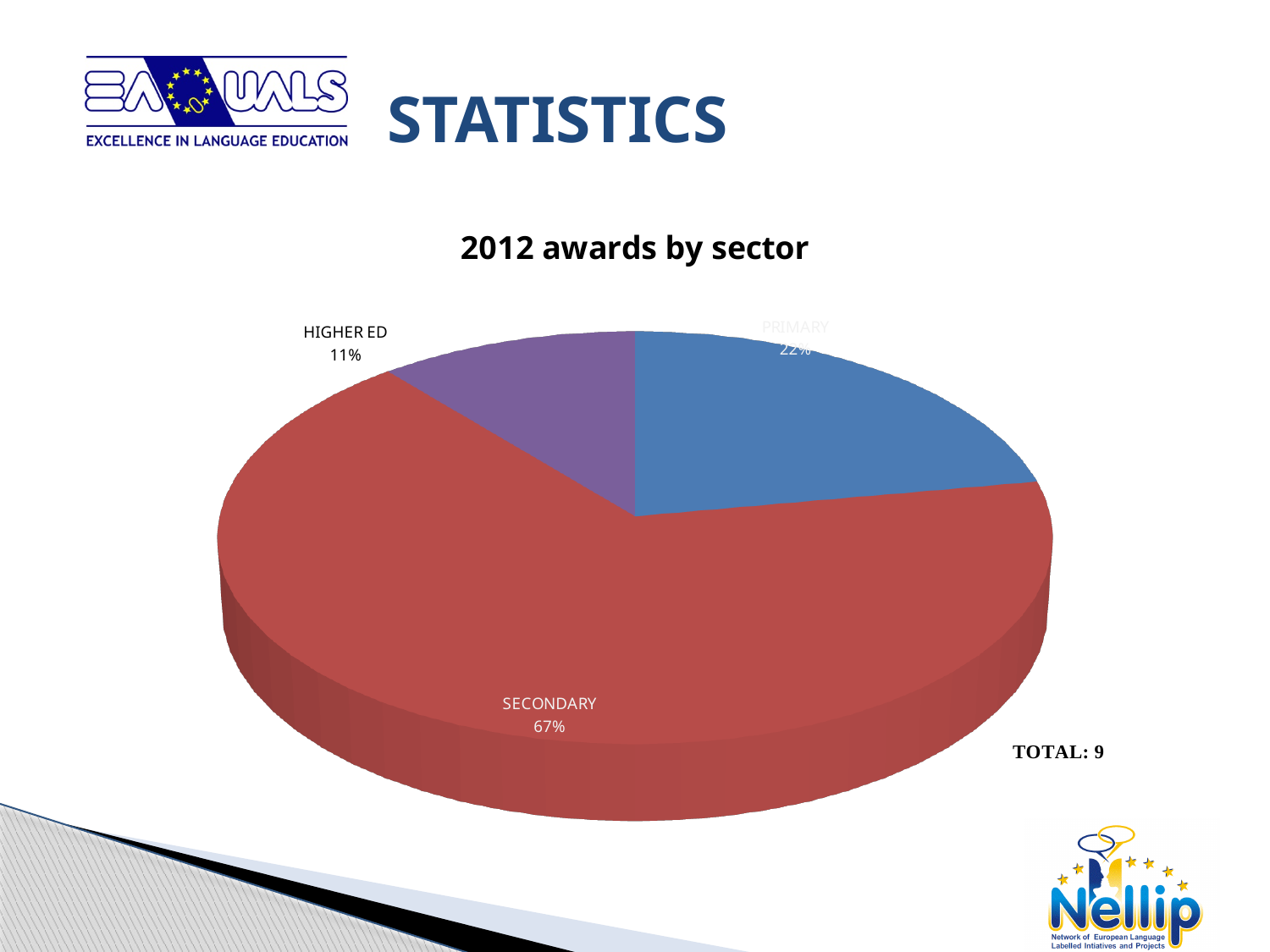
What kind of chart is shown on the slide? pie chart What is the difference in percentage points between SECONDARY and HIGHER ED? 56 What share of the pie does HIGHER ED have? 11% What share of the pie does SECONDARY have? 67% What is the difference in percentage points between PRIMARY and HIGHER ED? 11 How many sectors are shown in the pie chart? 3 Which sector has the smallest share of 2012 awards? HIGHER ED What total number of awards is stated next to the chart? 9 Which sector has the largest share of 2012 awards? SECONDARY What is the title of the chart? 2012 awards by sector What share of the pie does PRIMARY have? 22% Which has a larger share, PRIMARY or HIGHER ED? PRIMARY